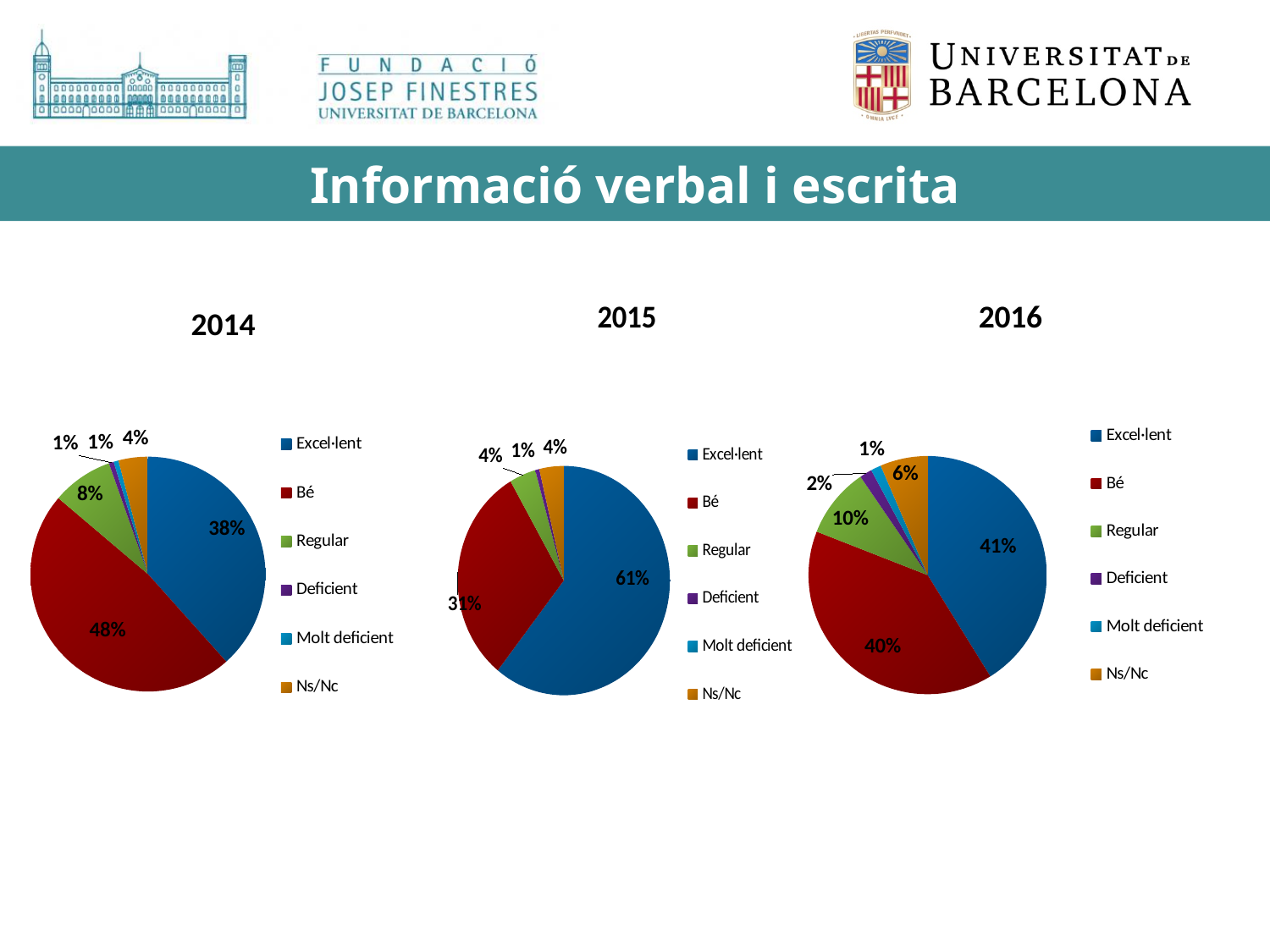
In the 2015 chart, which category has the largest slice? Excel·lent In the 2014 chart, what share of the pie is Excel·lent? 38% In the 2015 chart, what share of the pie is Bé? 31% What kind of charts are shown on the slide? Pie charts In the 2016 chart, what share of the pie is Regular? 10% In the 2014 chart, what share of the pie is Bé? 48% In the 2014 chart, which category has the largest slice? Bé In the 2016 chart, what share of the pie is Ns/Nc? 6% In the 2015 chart, what share of the pie is Excel·lent? 61% In the 2014 chart, what is the difference between the Bé and Excel·lent shares? 10% In the 2015 chart, which is larger, the Excel·lent slice or the Bé slice? Excel·lent How many categories does the legend of the 2016 chart list? 6